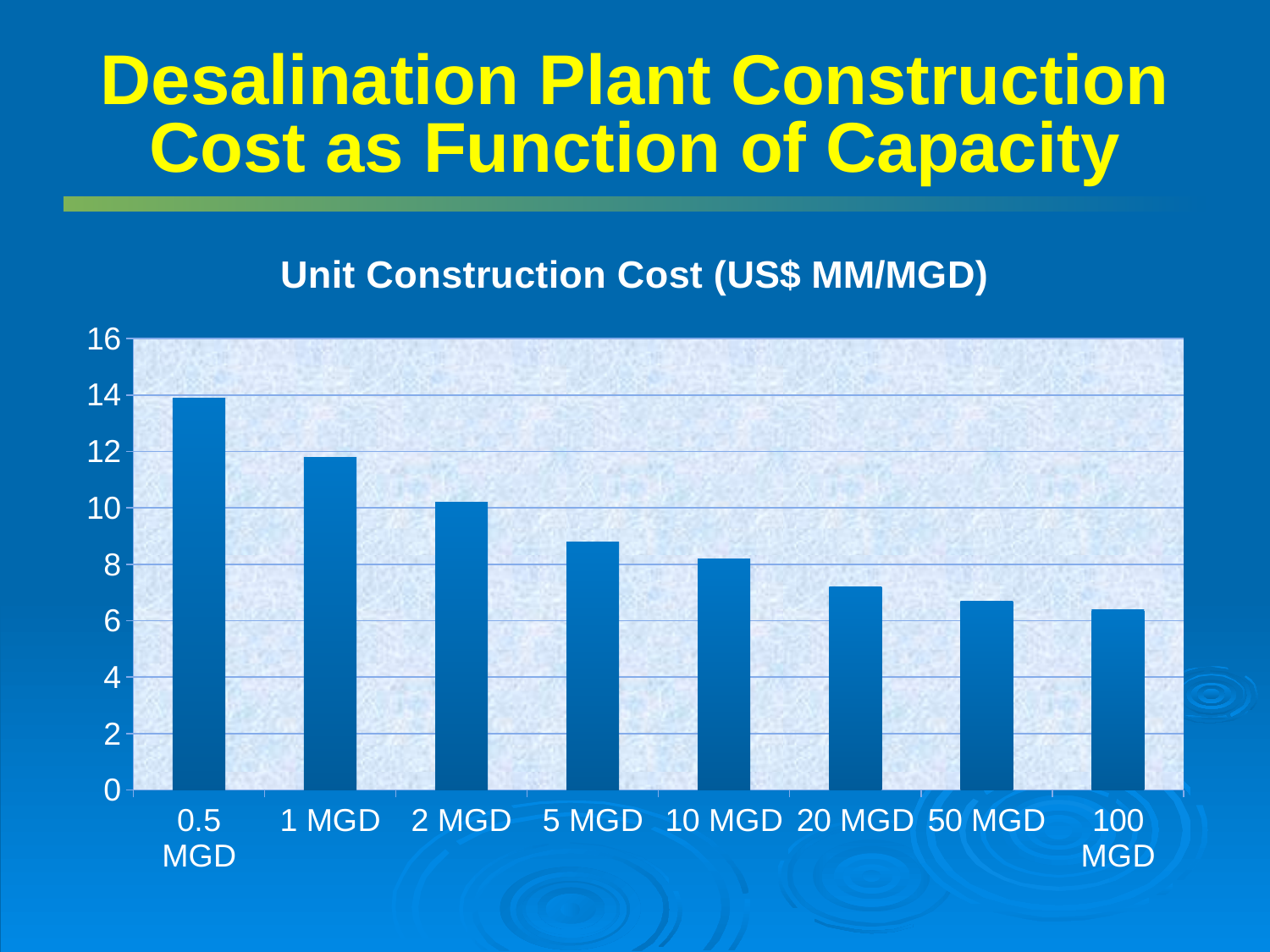
Is the value for 100 MGD greater or less than 6? greater Do the unit construction costs rise or fall as capacity increases along the x axis? fall Which has a larger unit construction cost, 2 MGD or 10 MGD? 2 MGD Which capacity has the lowest unit construction cost? 100 MGD Is the value for 20 MGD greater or less than 8? less What is the title of the chart? Unit Construction Cost (US$ MM/MGD) Is the value for 1 MGD greater or less than 10? greater Which capacity has the highest unit construction cost? 0.5 MGD What kind of chart is shown on the slide? bar chart How many capacity categories are shown on the x axis? 8